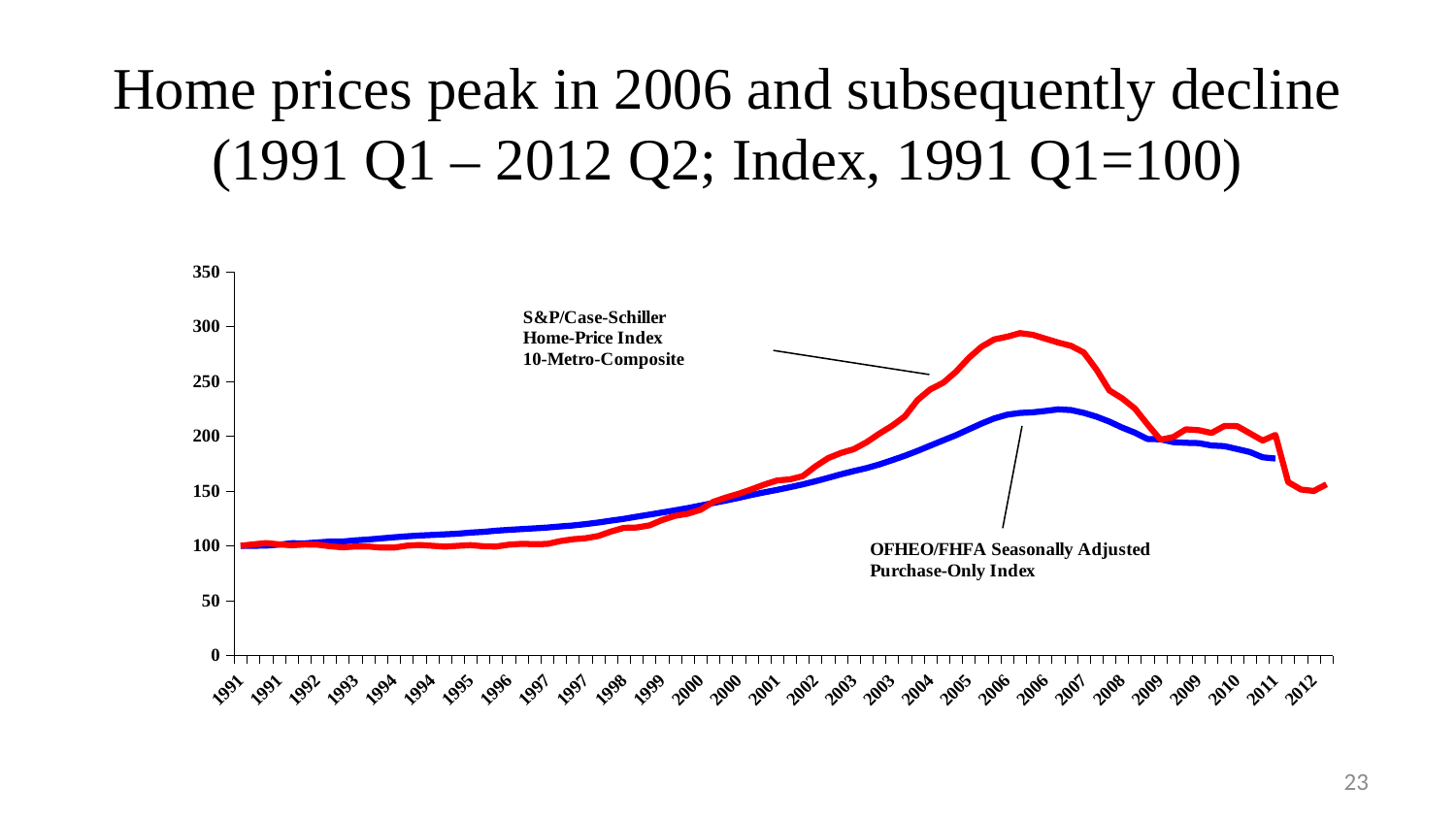
Is the value of the S&P/Case-Shiller Home-Price Index in 2012 greater or less than 200? less Which series reaches the higher peak value, the S&P/Case-Shiller index or the OFHEO/FHFA index? S&P/Case-Shiller Home-Price Index 10-Metro-Composite Does the S&P/Case-Shiller Home-Price Index rise or fall from 2006 to 2012? fall Is the peak value of the OFHEO/FHFA Seasonally Adjusted Purchase-Only Index greater or less than 250? less Does the OFHEO/FHFA Seasonally Adjusted Purchase-Only Index rise or fall from 1991 to 2006? rise Is the peak value of the S&P/Case-Shiller Home-Price Index 10-Metro-Composite greater or less than 250? greater How many data series are plotted on the chart? 2 Around 1997, which series has the higher value, the S&P/Case-Shiller index or the OFHEO/FHFA index? OFHEO/FHFA Seasonally Adjusted Purchase-Only Index What is the index value of both series at 1991 Q1, the base period? 100 What colour is the line for the S&P/Case-Shiller Home-Price Index 10-Metro-Composite? red What kind of chart is shown on the slide? line chart